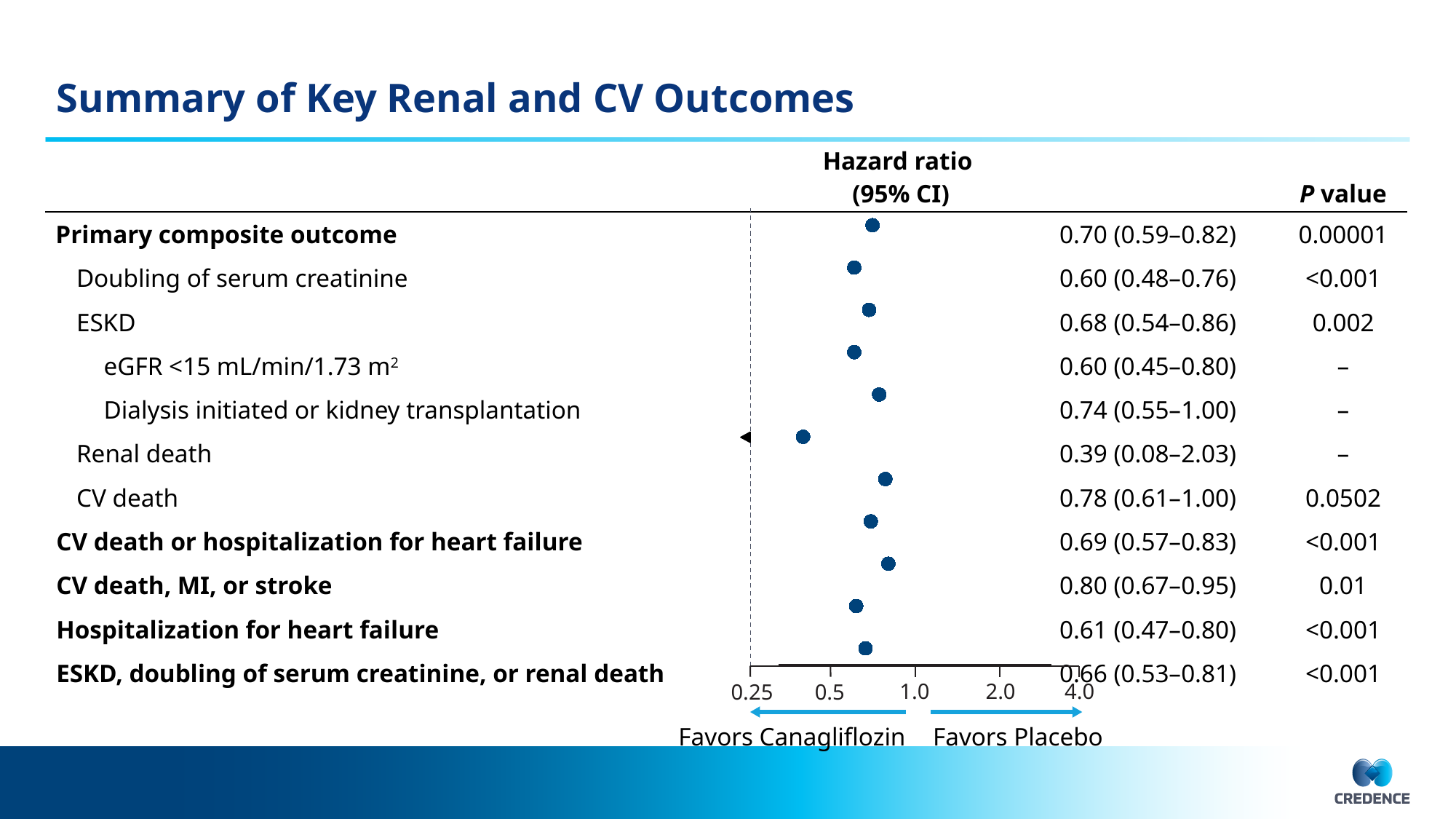
What is the P value for CV death? 0.0502 What is the 95% confidence interval for the hazard ratio for renal death? 0.08–2.03 What kind of chart is shown on the slide? Forest plot What is the hazard ratio for the primary composite outcome? 0.70 What is the difference between the hazard ratio for CV death and the hazard ratio for doubling of serum creatinine? 0.18 Which outcome has the lowest hazard ratio? Renal death How many outcomes are plotted in the forest plot? 11 What is the hazard ratio for hospitalization for heart failure? 0.61 What does the left arrow below the x axis indicate the direction favors? Favors Canagliflozin Which has the larger hazard ratio, ESKD or dialysis initiated or kidney transplantation? Dialysis initiated or kidney transplantation Is the hazard ratio for CV death, MI, or stroke greater or less than 1.0? less Which outcome has the highest hazard ratio? CV death, MI, or stroke